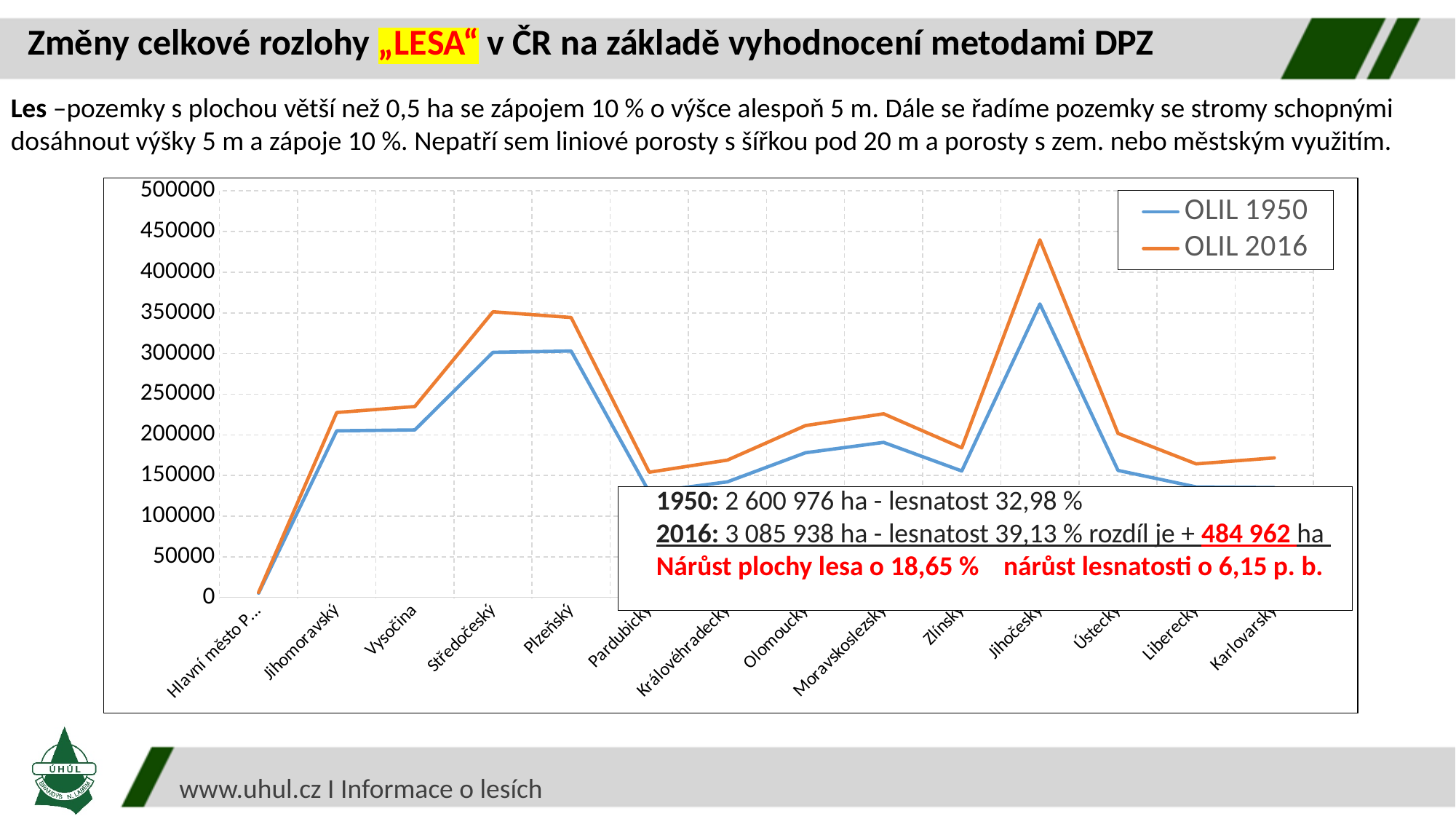
How many series does the chart legend list? 2 For Jihomoravský, which series has the larger value: OLIL 1950 or OLIL 2016? OLIL 2016 For the OLIL 2016 series, which is larger: the value for Jihočeský or the value for Středočeský? Jihočeský How many categories (regions) are plotted along the x axis? 14 Which colour is used for the OLIL 2016 line? orange What kind of chart is shown on the slide? line chart Is the OLIL 2016 value for Jihočeský greater or less than 400000? greater Which region has the highest value for the OLIL 2016 series? Jihočeský Is the OLIL 2016 value for Středočeský greater or less than 300000? greater Which region has the highest value for the OLIL 1950 series? Jihočeský Is the OLIL 1950 value for Jihočeský greater or less than 300000? greater